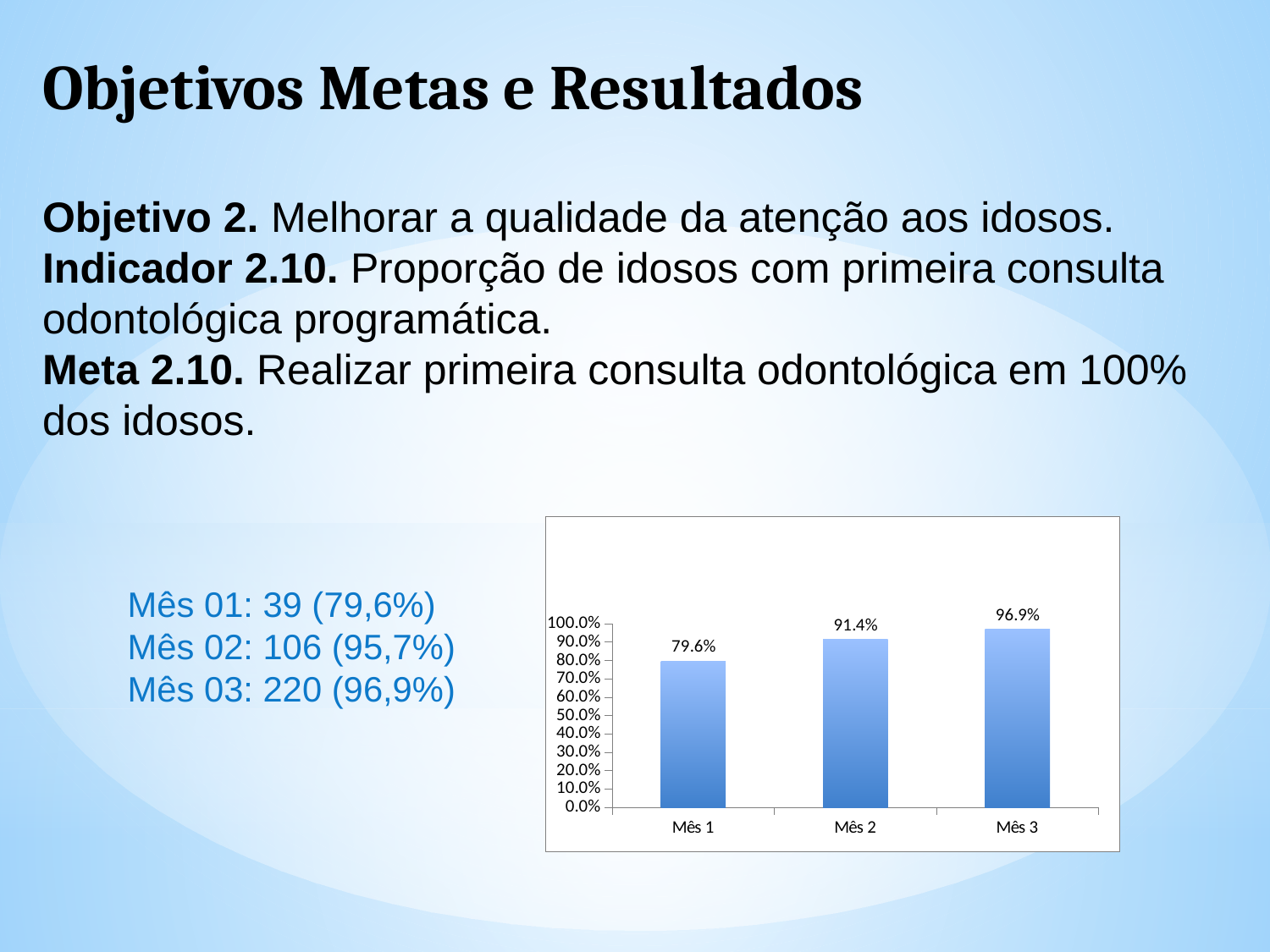
What is the value for Mês 3 in the chart? 96.9% Is the value for Mês 1 greater or less than 80.0%? less Which month has the lowest value in the chart? Mês 1 What is the value for Mês 1 in the chart? 79.6% What is the value for Mês 2 in the chart? 91.4% Do the values rise or fall from Mês 1 to Mês 3? rise Which month has the highest value in the chart? Mês 3 How many months are shown on the x axis of the chart? 3 Which is larger, the value for Mês 2 or the value for Mês 3? Mês 3 What kind of chart is shown on the slide? bar chart What is the difference between the values for Mês 3 and Mês 1? 17.3% What is the difference between the values for Mês 2 and Mês 1? 11.8%